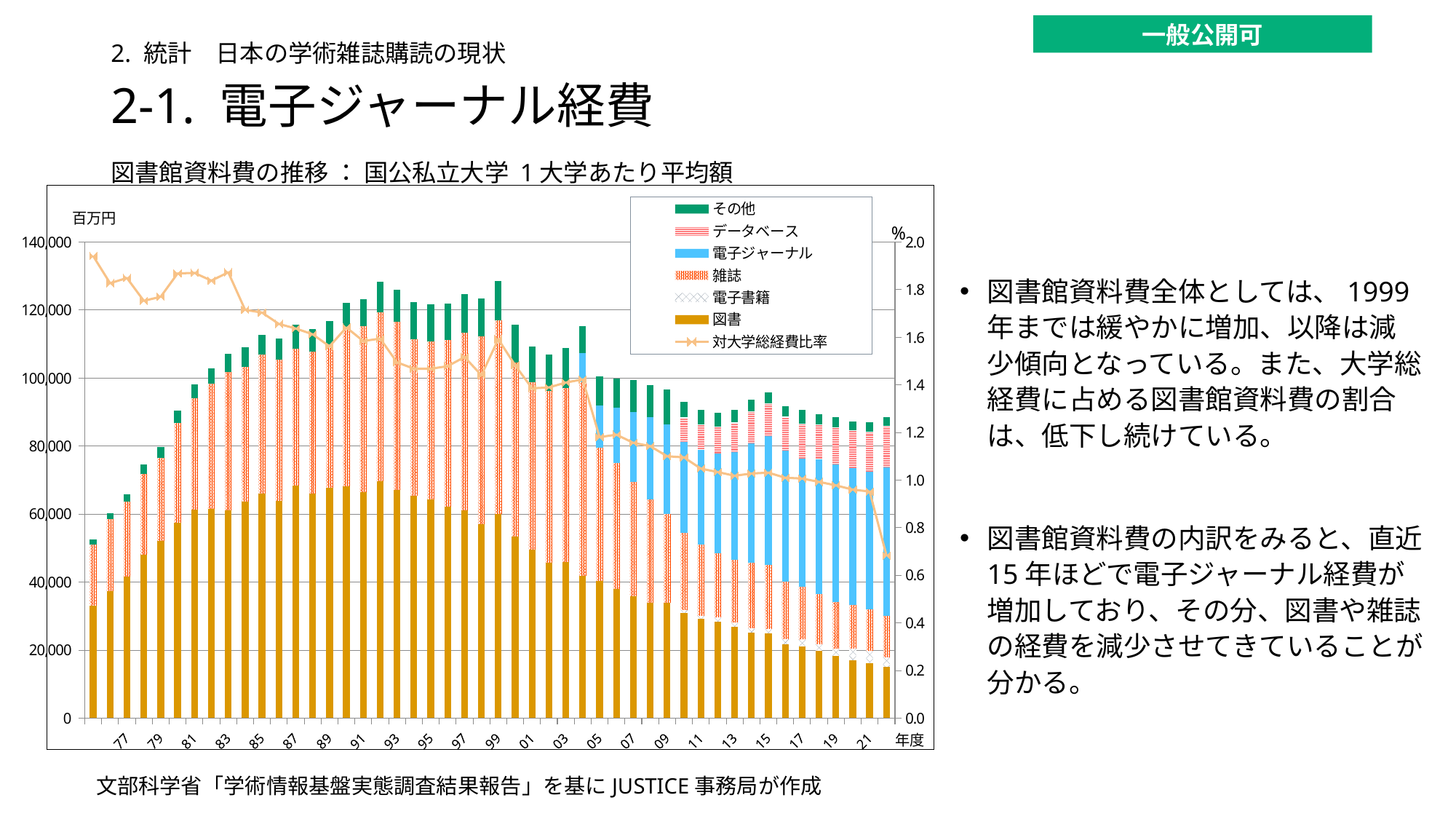
Is the 図書 value for 21 greater or less than 20,000? less How many series does the chart legend list? 7 Does the 対大学総経費比率 line generally rise or fall from left to right across the chart? fall Is the 電子ジャーナル segment larger in 21 or in 05? 21 Is the total library materials cost (full stacked bar) for 99 greater or less than 120,000? greater What is the title of the chart? 図書館資料費の推移：国公私立大学１大学あたり平均額 Is the value of 対大学総経費比率 at the left end of the chart greater or less than 1.8? greater What kind of chart is shown on the slide? Stacked bar chart with a line Which legend entry is plotted as a line rather than as bars? 対大学総経費比率